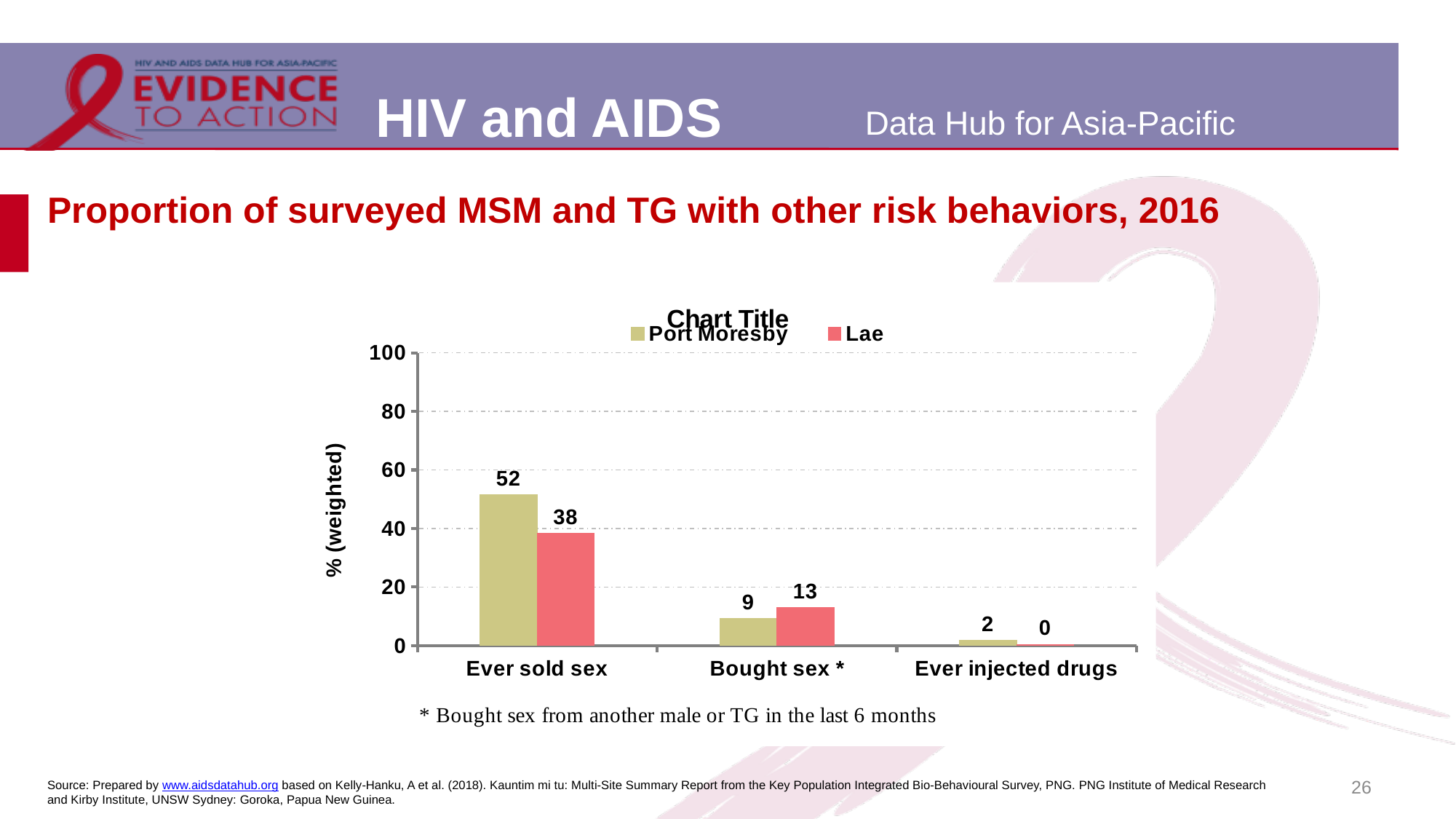
Is the value for Port Moresby in 'Ever sold sex' greater or less than 40? greater What is the value for Port Moresby in the 'Ever sold sex' category? 52 What is the value for Lae in the 'Ever injected drugs' category? 0 For 'Bought sex *', which series has the larger value, Port Moresby or Lae? Lae Which category has the highest value for Port Moresby? Ever sold sex How many categories are shown on the x axis? 3 What is the value for Lae in the 'Ever sold sex' category? 38 What is the value for Port Moresby in the 'Bought sex *' category? 9 What kind of chart is shown on the slide? Bar chart What is the difference between the Port Moresby and Lae values for 'Ever sold sex'? 14 Which category has the lowest value for Lae? Ever injected drugs How many series does the legend list? 2